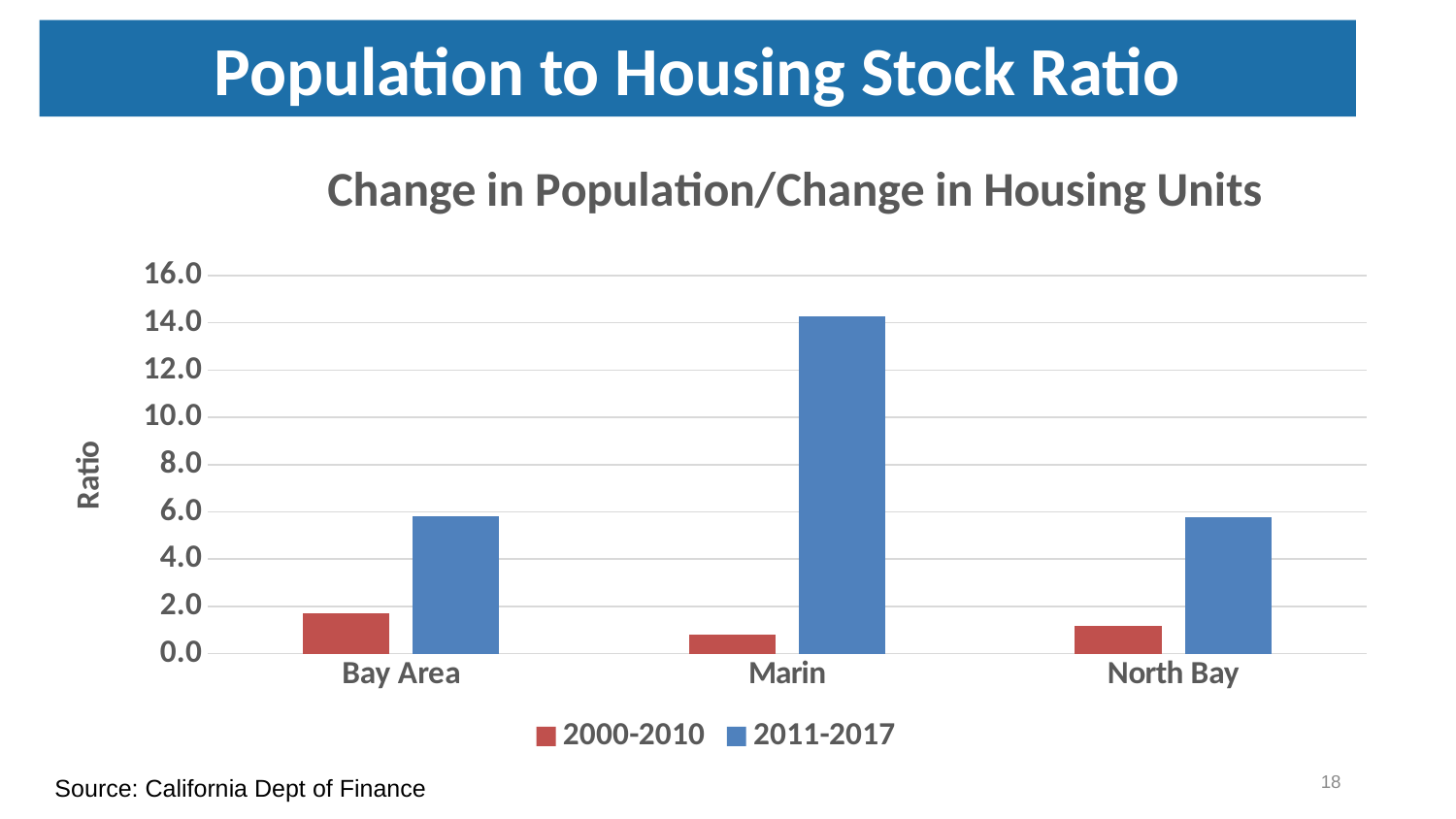
What kind of chart is shown on the slide? bar chart Which category has the highest value for the 2011-2017 series? Marin How many categories are shown on the x axis of the chart? 3 How many series does the legend list? 2 Is the 2011-2017 value for Marin greater or less than 12.0? greater Which category has the lowest value for the 2000-2010 series? Marin Which is larger: the 2000-2010 value for Bay Area or the 2000-2010 value for Marin? Bay Area Which category has the highest value for the 2000-2010 series? Bay Area Is the 2011-2017 value for Bay Area greater or less than 4.0? greater What is the label on the vertical axis of the chart? Ratio Is the 2000-2010 value for Marin greater or less than 2.0? less For Marin, which series has the larger value, 2000-2010 or 2011-2017? 2011-2017